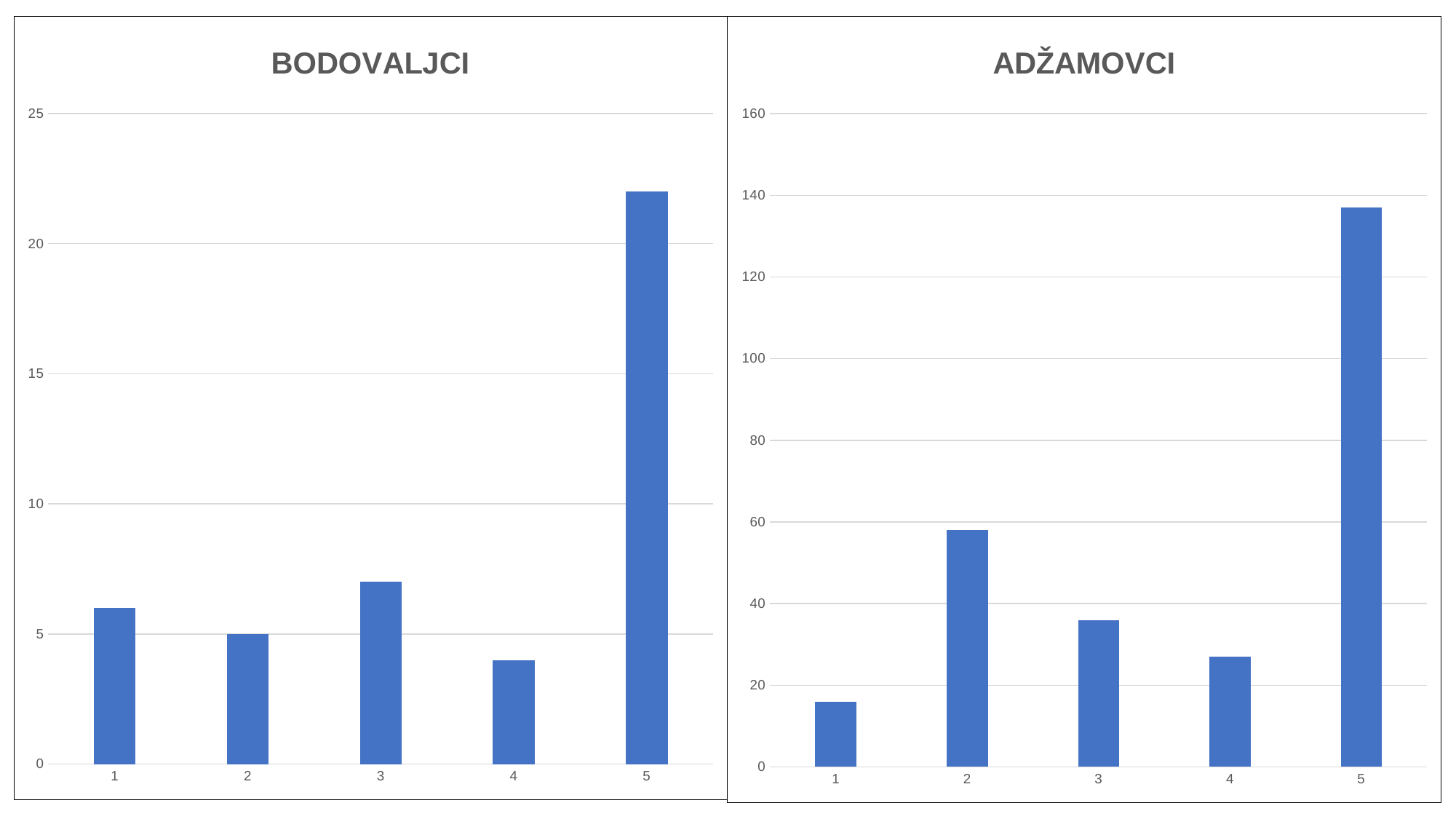
In the ADŽAMOVCI chart, which category has the lowest value? 1 In the BODOVALJCI chart, which category has the highest value? 5 In the BODOVALJCI chart, is the value for category 5 greater or less than 20? greater What kind of chart is the ADŽAMOVCI chart? bar chart In the ADŽAMOVCI chart, is the value for category 2 greater or less than 40? greater In the BODOVALJCI chart, is the value for category 4 greater or less than 5? less In the BODOVALJCI chart, which category has the lowest value? 4 In the ADŽAMOVCI chart, which is larger, the value for category 3 or the value for category 4? category 3 In the BODOVALJCI chart, what is the value for category 2? 5 In the ADŽAMOVCI chart, which category has the highest value? 5 In the BODOVALJCI chart, how many categories are shown on the x axis? 5